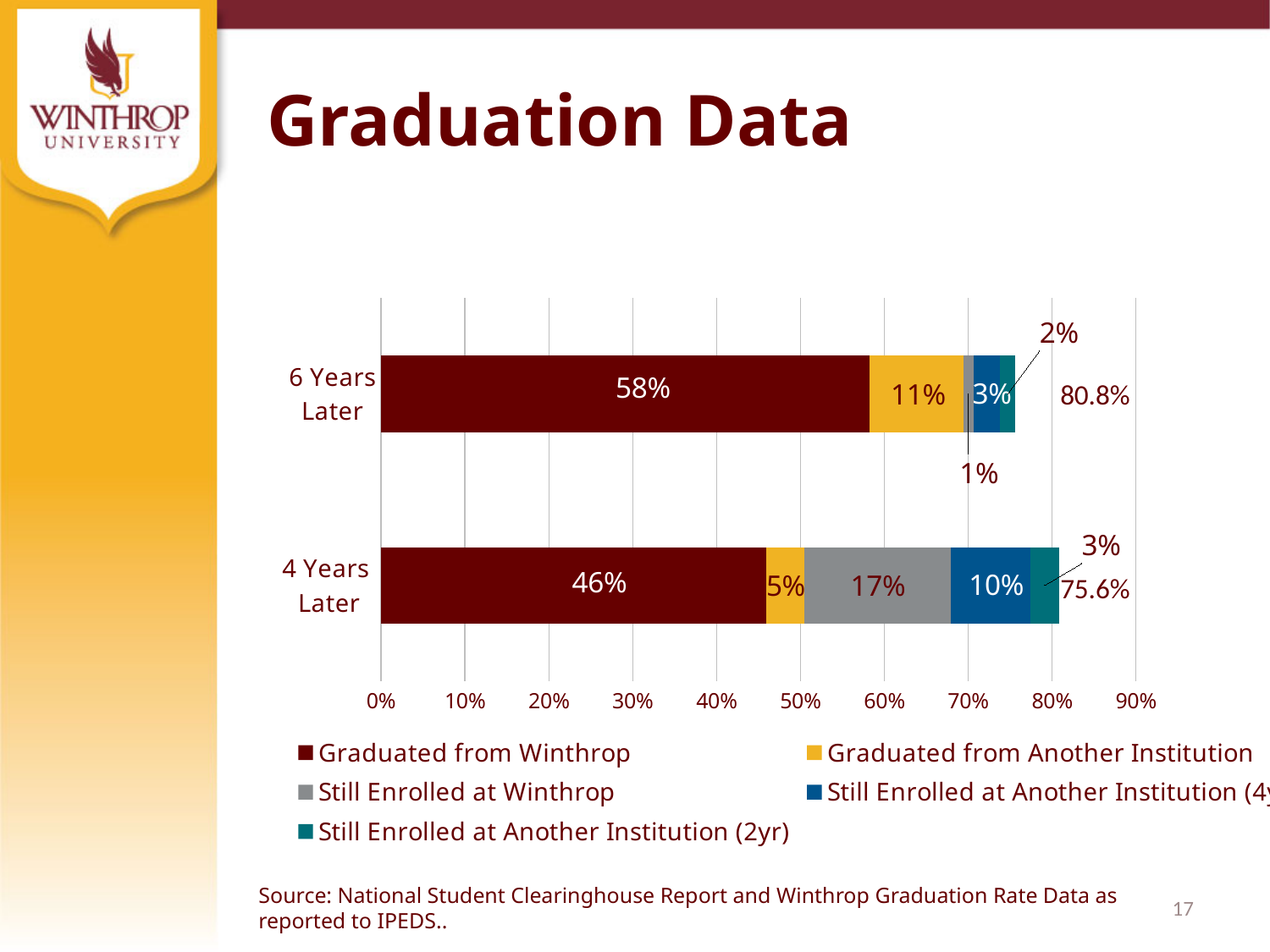
What percentage of students had Graduated from Winthrop 4 Years Later? 46% What is the value for Graduated from Another Institution in the 6 Years Later bar? 11% Which bar has the larger Still Enrolled at Winthrop segment, 6 Years Later or 4 Years Later? 4 Years Later How much higher is the Graduated from Winthrop share 6 Years Later than 4 Years Later? 12% What is the value for Still Enrolled at Winthrop in the 4 Years Later bar? 17% What percentage of students had Graduated from Winthrop 6 Years Later? 58% What kind of chart is shown on the slide? Stacked bar chart How many series does the legend list? 5 What total percentage is printed at the end of the 6 Years Later bar? 80.8% How many categories are plotted on the chart? 2 What total percentage is printed at the end of the 4 Years Later bar? 75.6% What is the value for Still Enrolled at Another Institution (4yr) in the 4 Years Later bar? 10%